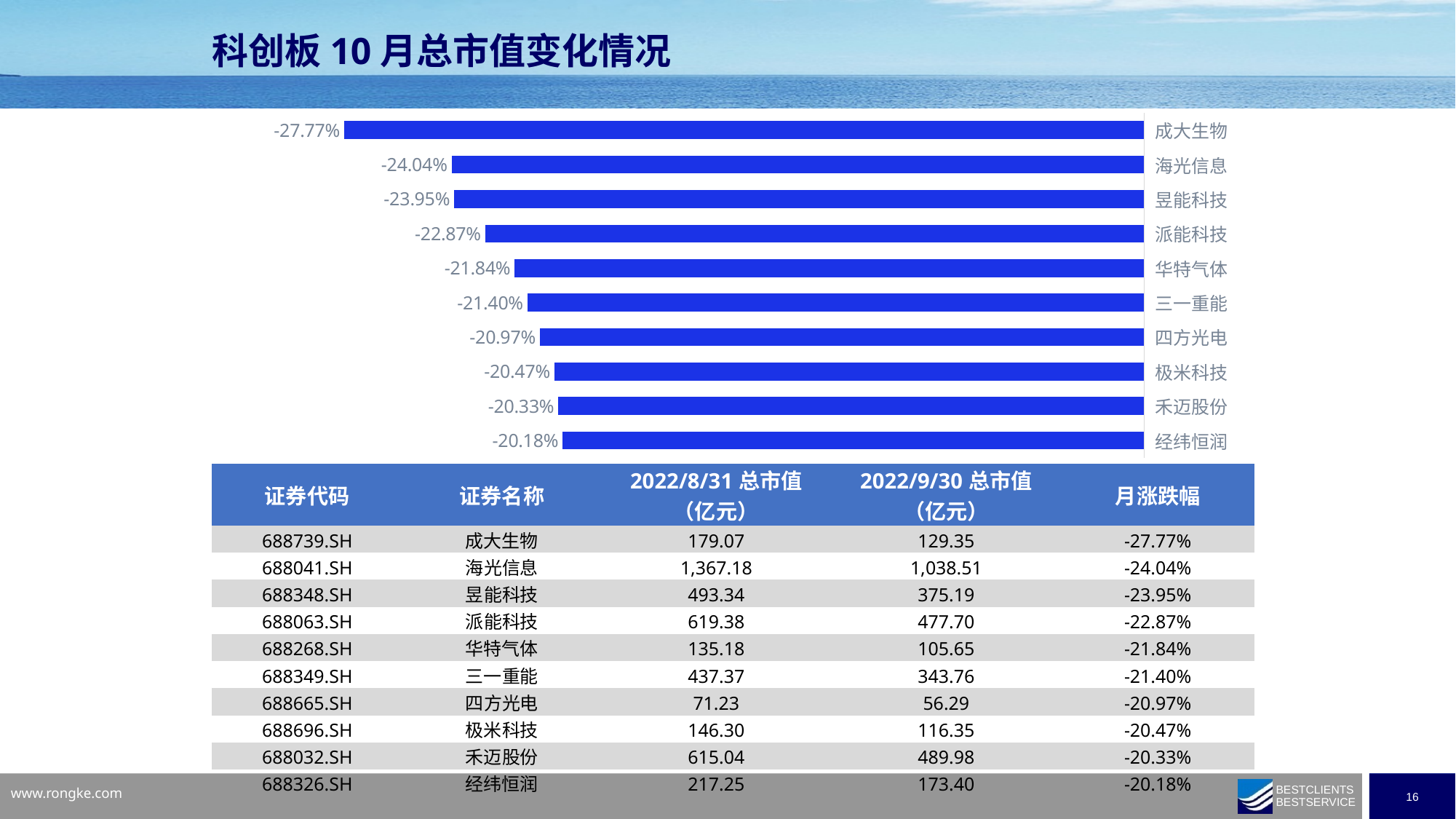
What is the title of the slide containing the chart? 科创板 10 月总市值变化情况 By how many percentage points does the decline of 成大生物 exceed that of 海光信息? 3.73 percentage points What is the value shown for 华特气体 in the chart? -21.84% By how many percentage points does the decline of 成大生物 exceed that of 经纬恒润? 7.59 percentage points Which company has the largest decline (the most negative value) in the chart? 成大生物 How many companies are shown as bars in the chart? 10 What kind of chart is shown on the slide? bar chart What is the value shown for 经纬恒润 in the chart? -20.18% Which company shows a larger decline, 派能科技 or 四方光电? 派能科技 What is the value shown for 海光信息 in the chart? -24.04% What is the value shown for 成大生物 in the chart? -27.77% Which company has the smallest decline (the least negative value) in the chart? 经纬恒润